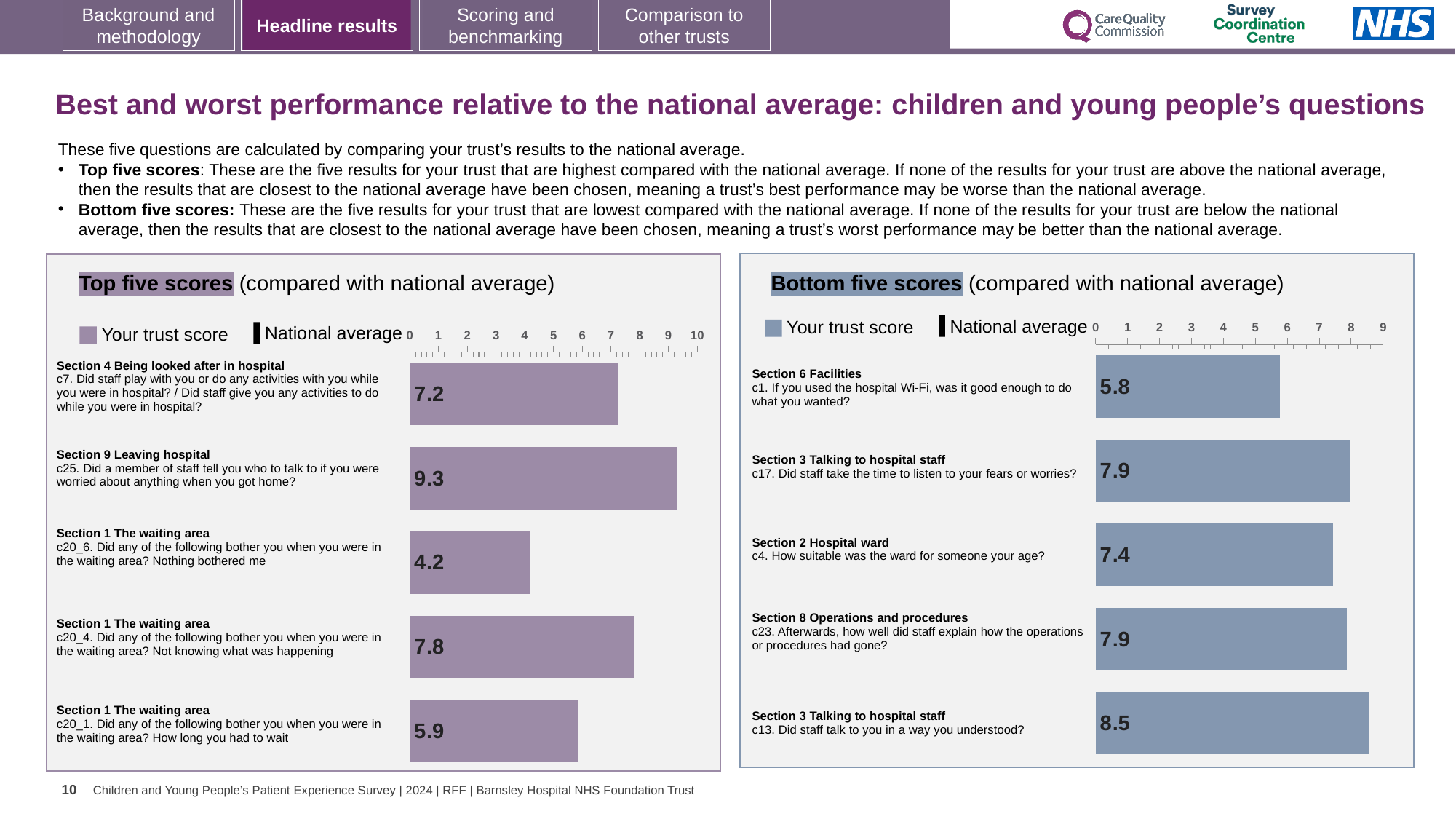
In the Top five scores chart, what is the difference between the trust scores for c25 and c7? 2.1 What two entries does the legend of the Top five scores chart list? Your trust score and National average In the Top five scores chart, which question has the highest trust score? c25 (Section 9 Leaving hospital) In the Bottom five scores chart, which question has the highest trust score? c13 (Did staff talk to you in a way you understood?) In the Bottom five scores chart, which question has the lowest trust score? c1 (Section 6 Facilities) In the Top five scores chart, what is the trust score for c20_6 (Nothing bothered me in the waiting area)? 4.2 What type of chart is used for the Bottom five scores? Bar chart In the Top five scores chart, what is the trust score for c25 (Did a member of staff tell you who to talk to if you were worried about anything when you got home?)? 9.3 In the Top five scores chart, which question has the lowest trust score? c20_6 (Nothing bothered me) In the Bottom five scores chart, which has the larger trust score: c4 (How suitable was the ward for someone your age?) or c13 (Did staff talk to you in a way you understood?)? c13 In the Bottom five scores chart, what is the trust score for c1 (hospital Wi-Fi)? 5.8 How many bars are shown in the Top five scores chart? 5